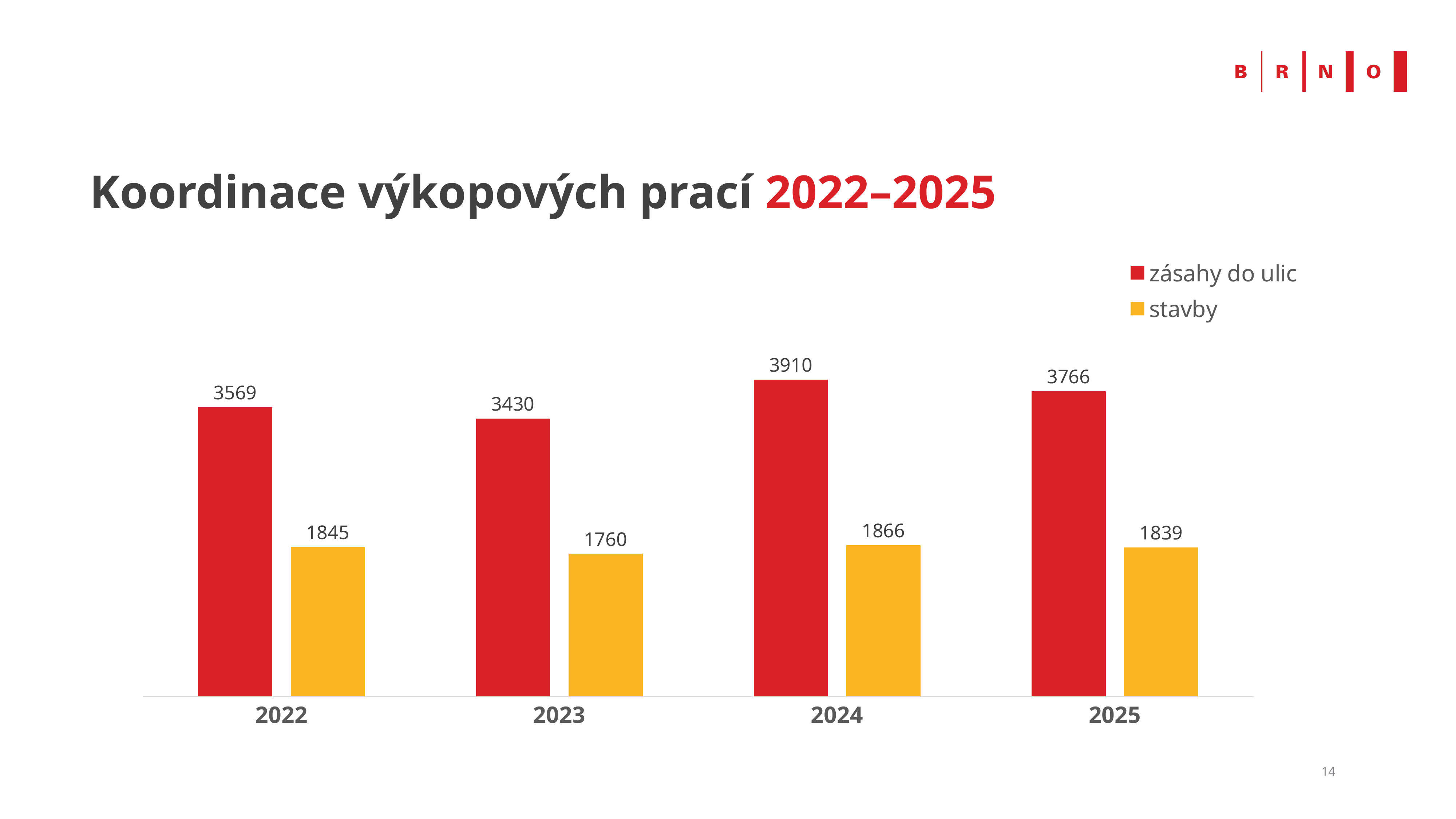
In which year is "zásahy do ulic" highest? 2024 What kind of chart is shown on the slide? bar chart What colour are the "stavby" bars? yellow What is the value of "stavby" for 2023? 1760 What is the value of "zásahy do ulic" for 2022? 3569 How many years are shown on the x axis? 4 What is the value of "zásahy do ulic" for 2024? 3910 How many series does the legend list? 2 In which year is "stavby" lowest? 2023 What is the difference between "zásahy do ulic" and "stavby" in 2025? 1927 What is the difference between "zásahy do ulic" in 2024 and in 2023? 480 Which is larger: "zásahy do ulic" in 2022 or in 2023? 2022